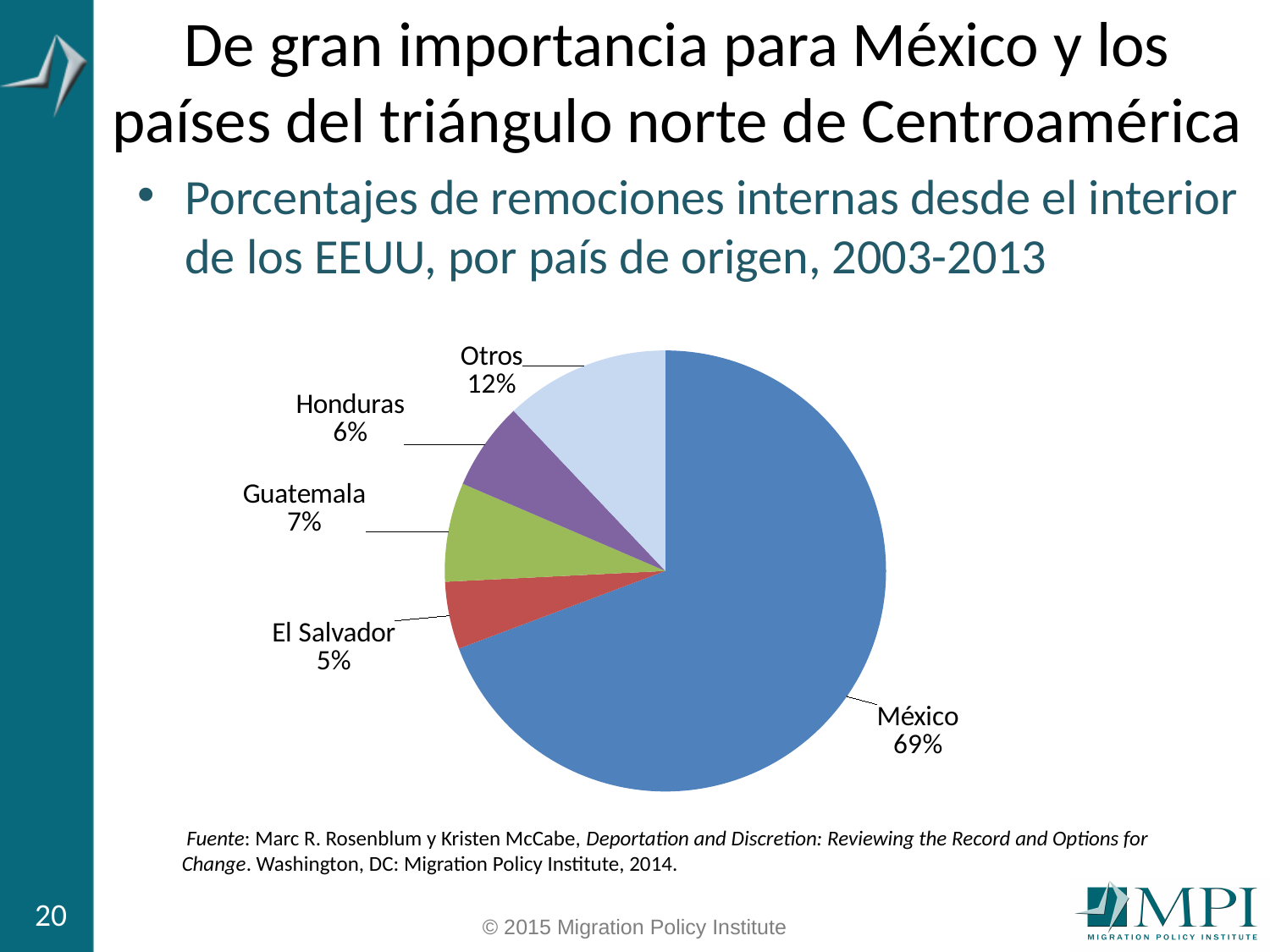
Which country has the largest slice of the pie? México What type of chart is shown on the slide? Pie chart What share of the pie does México account for? 69% What percentage is shown for Honduras? 6% How many slices does the pie chart have? 5 What percentage is shown for El Salvador? 5% Which category has the smallest slice of the pie? El Salvador Which is larger, the share for Guatemala or the share for Honduras? Guatemala What is the combined share of El Salvador, Guatemala and Honduras? 18% What percentage is shown for Otros? 12% What percentage is shown for Guatemala? 7% What is the difference in percentage points between México and Otros? 57